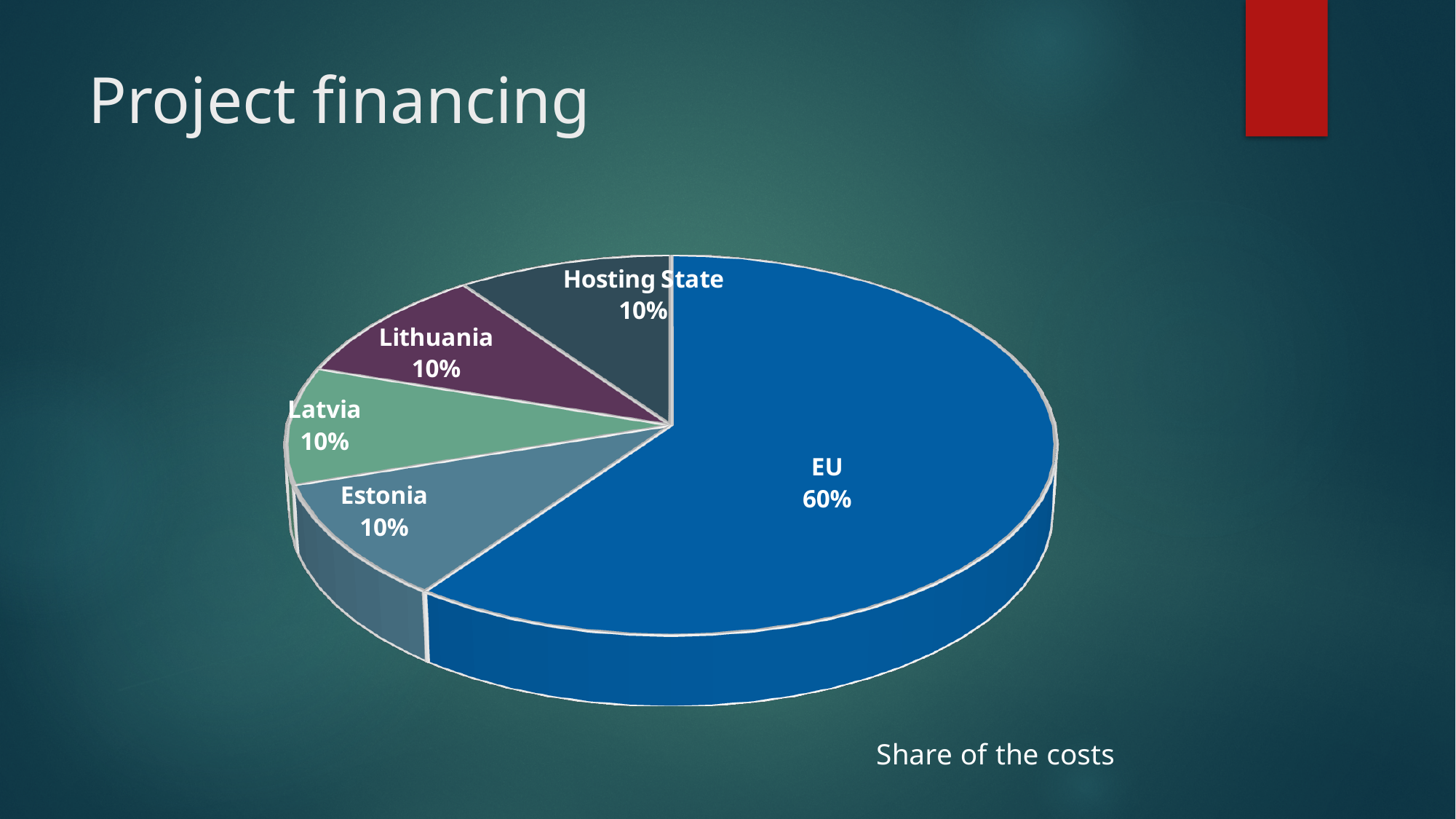
What share of the costs does Lithuania cover? 10% What caption appears below the pie chart? Share of the costs How many slices does the pie chart have? 5 What share of the costs does Estonia cover? 10% Which is larger, the EU's share or Estonia's share? EU What is the combined share of Estonia, Latvia and Lithuania? 30% What kind of chart is shown on the slide? Pie chart What is the title of the slide containing the chart? Project financing What is the difference between the EU's share and Latvia's share? 50% Which contributor has the largest share of the costs? EU What share of the costs does the EU cover? 60% What share of the costs does the Hosting State cover? 10%